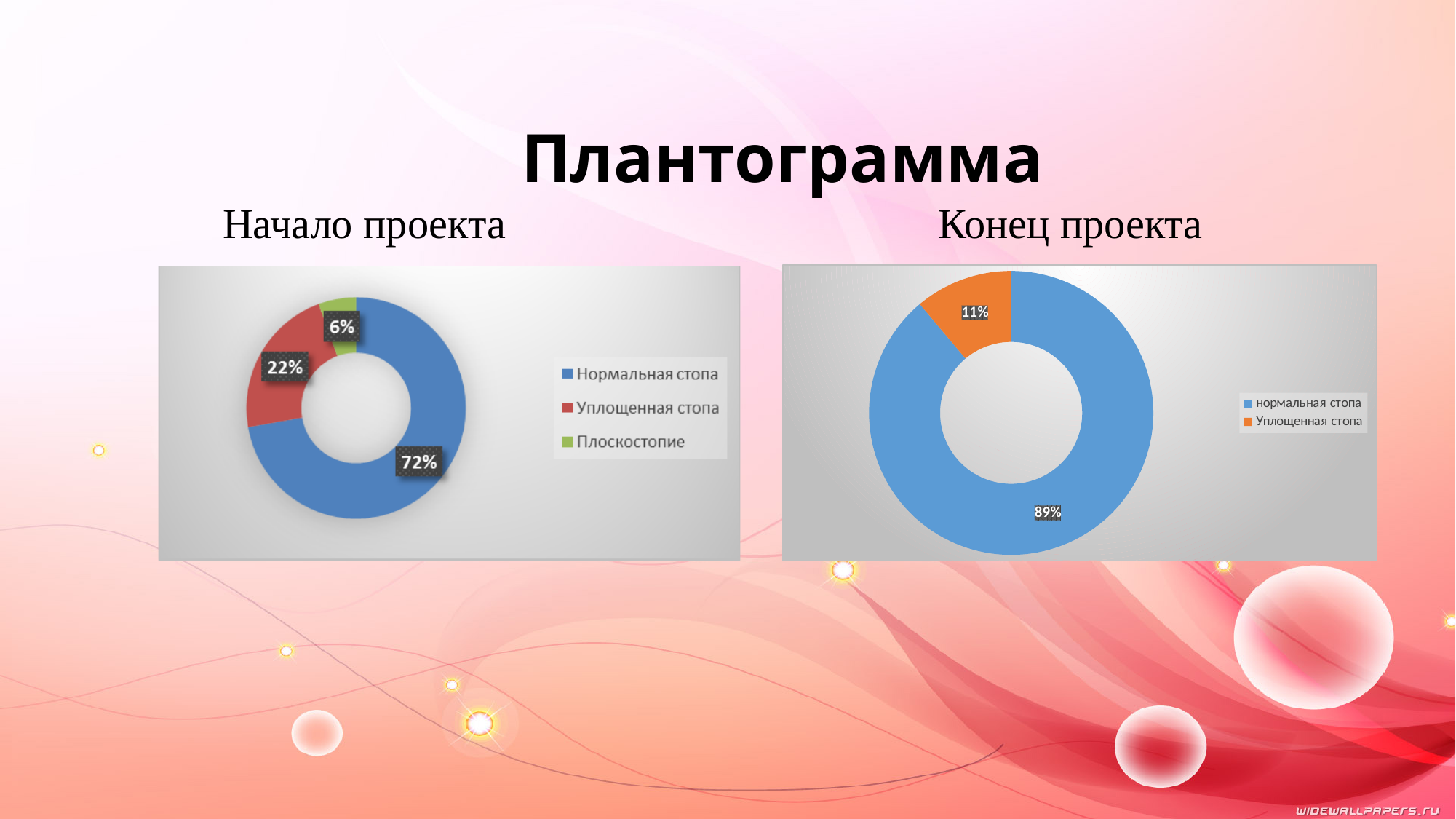
In the 'Конец проекта' chart, what is the difference between the shares of нормальная стопа and Уплощенная стопа? 78% How many categories does the legend of the 'Конец проекта' chart list? 2 In the 'Начало проекта' chart, which category has the largest share? Нормальная стопа What kind of chart is the 'Конец проекта' chart? Doughnut (pie) chart In the 'Конец проекта' chart, what share is labelled for нормальная стопа? 89% In the 'Начало проекта' chart, what share is labelled for Нормальная стопа? 72% In the 'Начало проекта' chart, what is the difference between the shares of Нормальная стопа and Уплощенная стопа? 50% In the 'Начало проекта' chart, which category has the smallest share? Плоскостопие In the 'Начало проекта' chart, what share is labelled for Плоскостопие? 6% How many categories does the legend of the 'Начало проекта' chart list? 3 In the 'Конец проекта' chart, what share is labelled for Уплощенная стопа? 11% In the 'Начало проекта' chart, what share is labelled for Уплощенная стопа? 22%